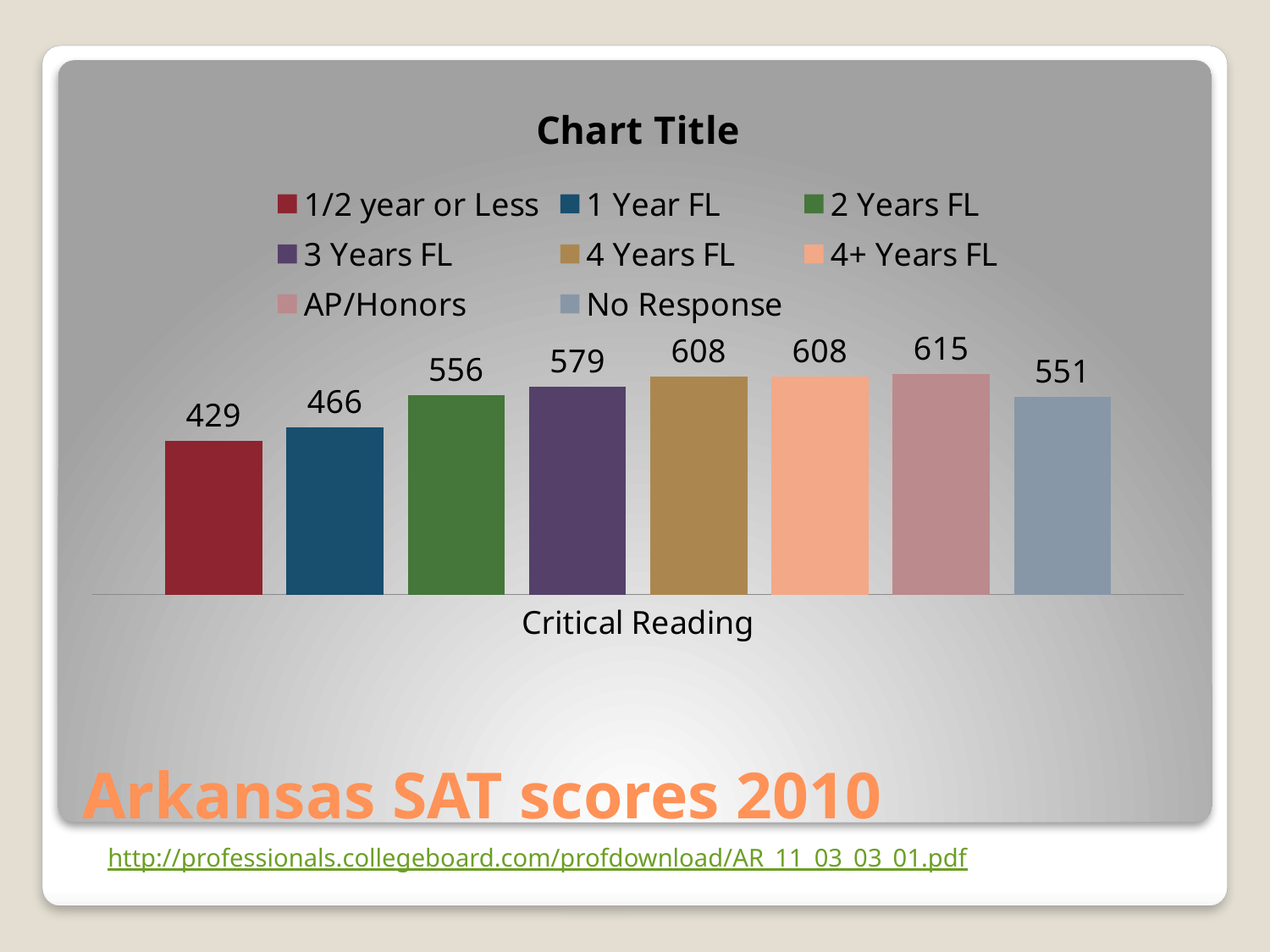
What is the Critical Reading score for 3 Years FL? 579 Which is larger, the Critical Reading score for 4 Years FL or for No Response? 4 Years FL What is the category label shown on the x axis? Critical Reading What kind of chart is shown on the slide? bar chart What is the title shown above the chart? Chart Title How many series does the legend list? 8 Which series has the highest Critical Reading score? AP/Honors What is the difference between the Critical Reading scores for 2 Years FL and 1 Year FL? 90 What is the difference between the Critical Reading scores for AP/Honors and 1/2 year or Less? 186 Which series has the lowest Critical Reading score? 1/2 year or Less What is the Critical Reading score for No Response? 551 What is the Critical Reading score for 1/2 year or Less? 429